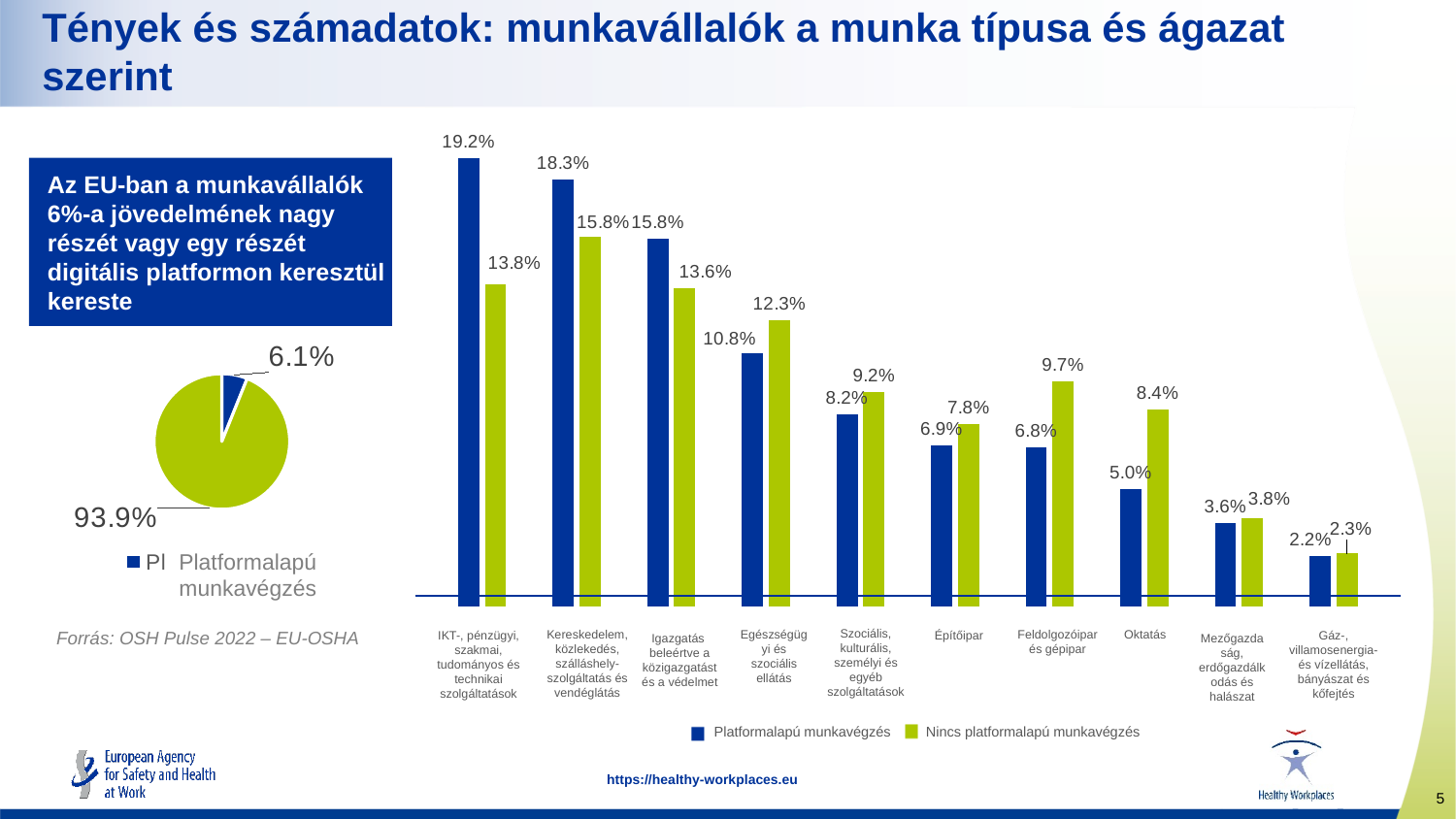
In the bar chart, what is the difference between the Platformalapú munkavégzés and Nincs platformalapú munkavégzés values for Feldolgozóipar és gépipar? 2.9% In the bar chart, which category has the highest value for Platformalapú munkavégzés? IKT-, pénzügyi, szakmai, tudományos és technikai szolgáltatások In the bar chart, what is the value for Nincs platformalapú munkavégzés in Oktatás? 8.4% In the bar chart, which colour represents Nincs platformalapú munkavégzés? Green In the bar chart, what is the value for Platformalapú munkavégzés in Építőipar? 6.9% What kind of chart is the chart on the right side of the slide? Bar chart In the bar chart, do the Platformalapú munkavégzés values rise or fall from left to right along the x axis? Fall How many categories are shown on the x axis of the bar chart? 10 In the bar chart, which category has the lowest value for Nincs platformalapú munkavégzés? Gáz-, villamosenergia- és vízellátás, bányászat és kőfejtés In the pie chart on the left, what share does the smaller slice represent? 6.1% In the bar chart, for Egészségügyi és szociális ellátás, which series has the larger value: Platformalapú munkavégzés or Nincs platformalapú munkavégzés? Nincs platformalapú munkavégzés How many series does the legend of the bar chart list? 2